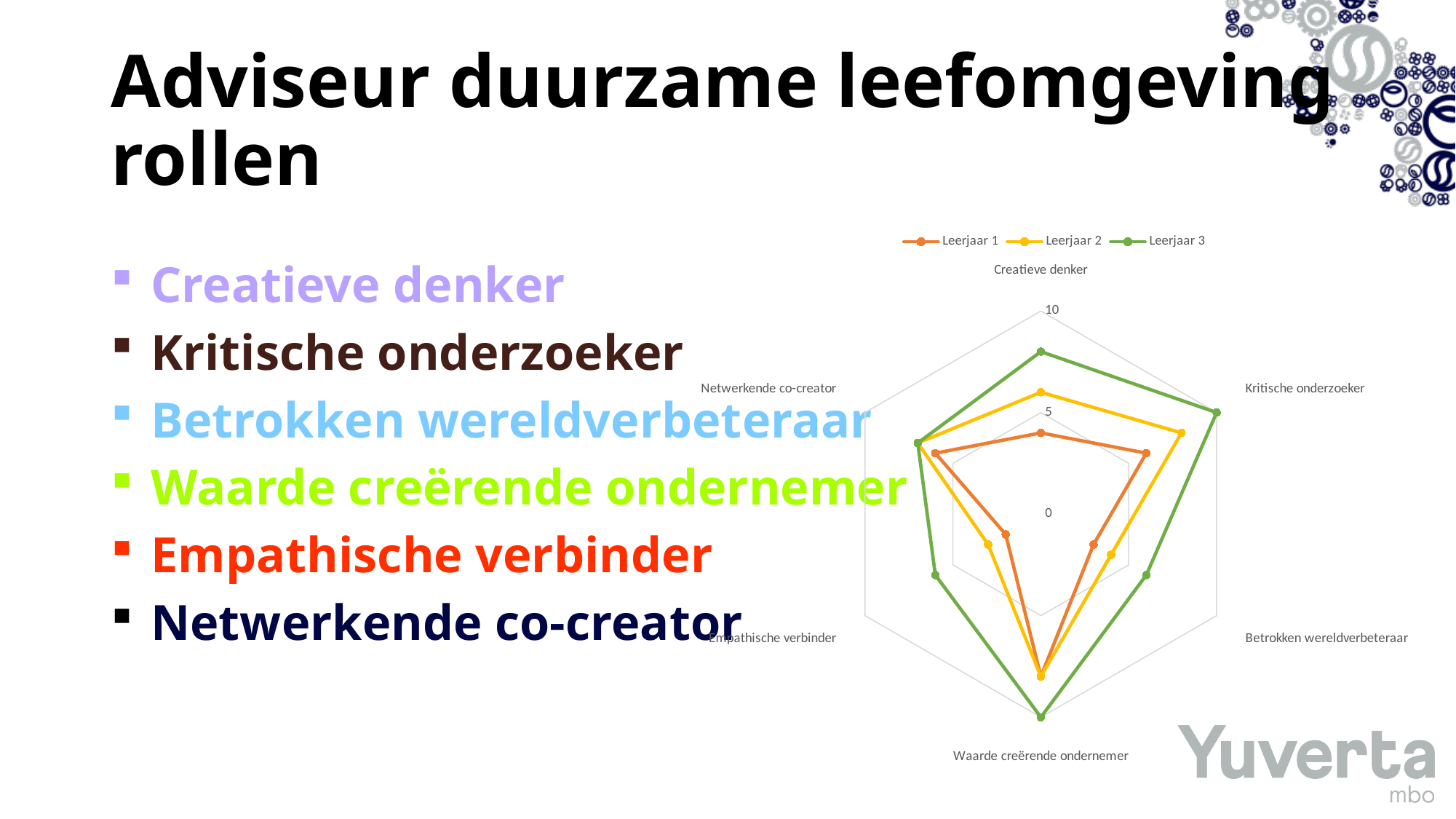
For Creatieve denker, which series has the larger value: Leerjaar 1 or Leerjaar 3? Leerjaar 3 Is the value of Leerjaar 1 for Empathische verbinder greater or less than 5? less What kind of chart is shown on the slide? Radar chart How many categories (axes) does the radar chart have? 6 Is the value of Leerjaar 2 for Betrokken wereldverbeteraar greater or less than 5? less Is the value of Leerjaar 3 for Waarde creërende ondernemer greater or less than 5? greater Which series are listed in the chart legend? Leerjaar 1, Leerjaar 2, Leerjaar 3 What is the highest value shown on the chart's axis scale? 10 For the Leerjaar 1 series, which category has the highest value? Waarde creërende ondernemer How many series does the chart legend list? 3